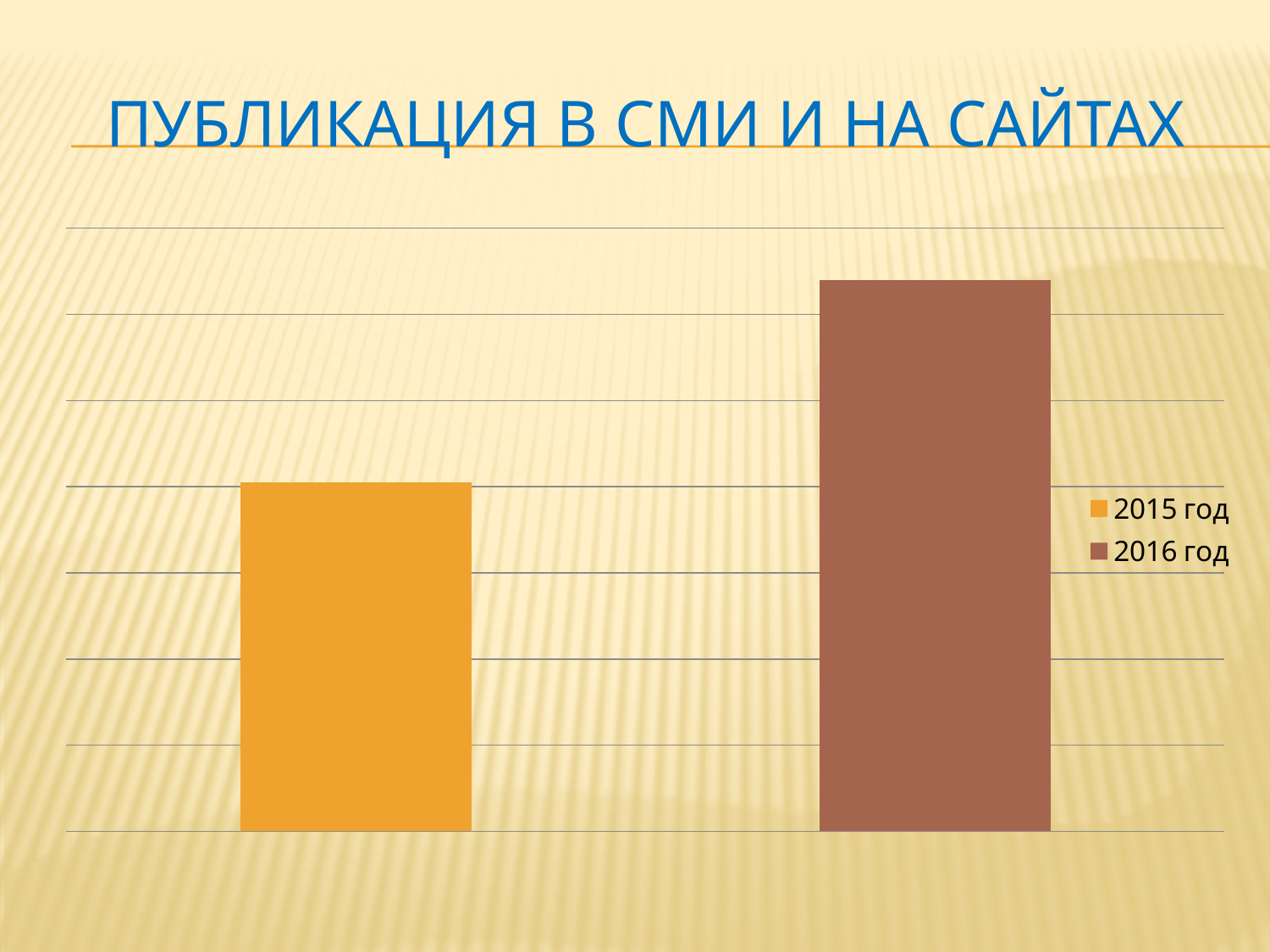
Do the bars rise or fall from 2015 год to 2016 год? rise What is the title of the slide? ПУБЛИКАЦИЯ В СМИ И НА САЙТАХ How many bars are plotted in the chart? 2 Which series has the shorter bar? 2015 год Which series has the taller bar, 2015 год or 2016 год? 2016 год What colour is the bar for 2015 год? orange Is the bar for 2016 год taller or shorter than the bar for 2015 год? taller What kind of chart is shown on the slide? bar chart How many series does the legend list? 2